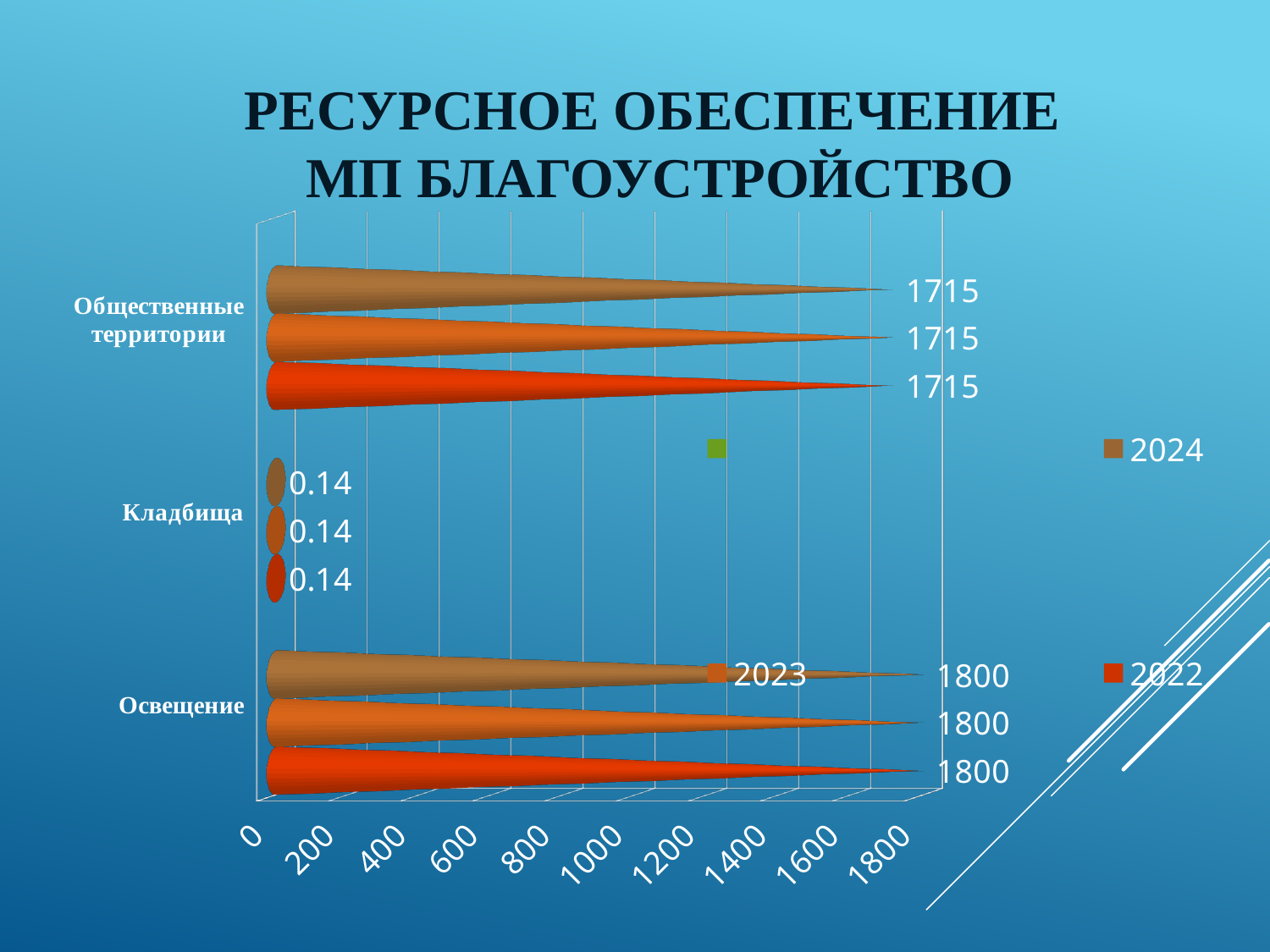
Which category has the highest value in 2022? Освещение What kind of chart is shown on the slide? bar chart What is the value for Освещение in 2022? 1800 What is the value for Общественные территории in 2023? 1715 What is the difference between the 2022 values for Освещение and Общественные территории? 85 Which is larger in 2024: Освещение or Общественные территории? Освещение Is the value for Общественные территории in 2022 greater or less than 1600? greater How many categories are shown on the chart? 3 What is the value for Кладбища in 2024? 0.14 Which category has the lowest value in 2024? Кладбища How many years does the legend list? 3 What is the title of the slide? РЕСУРСНОЕ ОБЕСПЕЧЕНИЕ МП БЛАГОУСТРОЙСТВО